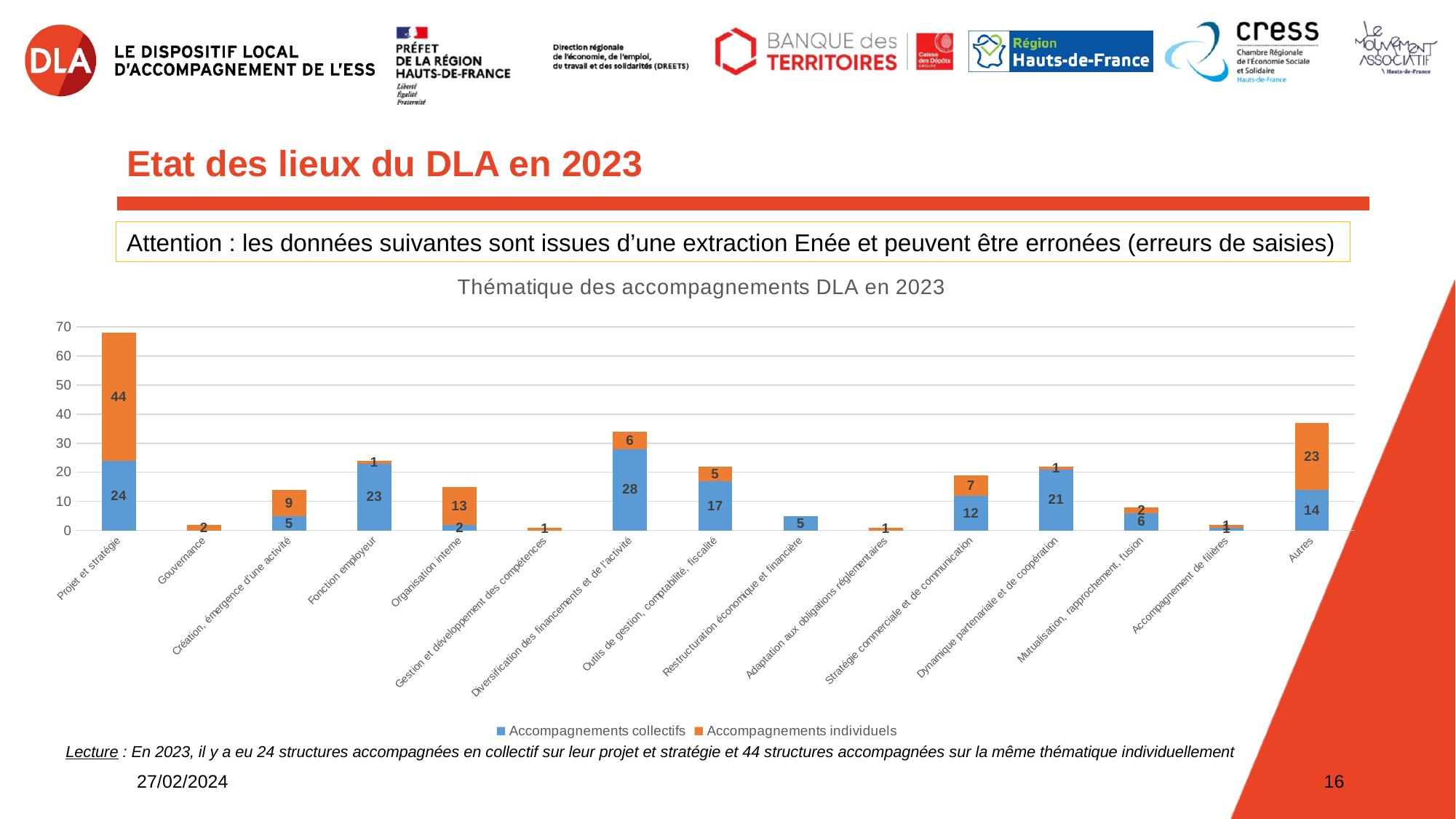
What is the value of Accompagnements collectifs for Diversification des financements et de l'activité? 28 What kind of chart is shown on the slide? Stacked bar chart Which is larger for Outils de gestion, comptabilité, fiscalité: Accompagnements collectifs or Accompagnements individuels? Accompagnements collectifs What is the difference between Accompagnements individuels and Accompagnements collectifs for Projet et stratégie? 20 What is the total of the stacked bar for Autres? 37 What is the total of the stacked bar for Stratégie commerciale et de communication? 19 What is the title of the chart? Thématique des accompagnements DLA en 2023 How many series does the legend list? 2 Which category has the highest total number of accompagnements? Projet et stratégie How many categories are shown on the x axis? 15 What is the value of Accompagnements individuels for Projet et stratégie? 44 What is the value of Accompagnements individuels for Organisation interne? 13